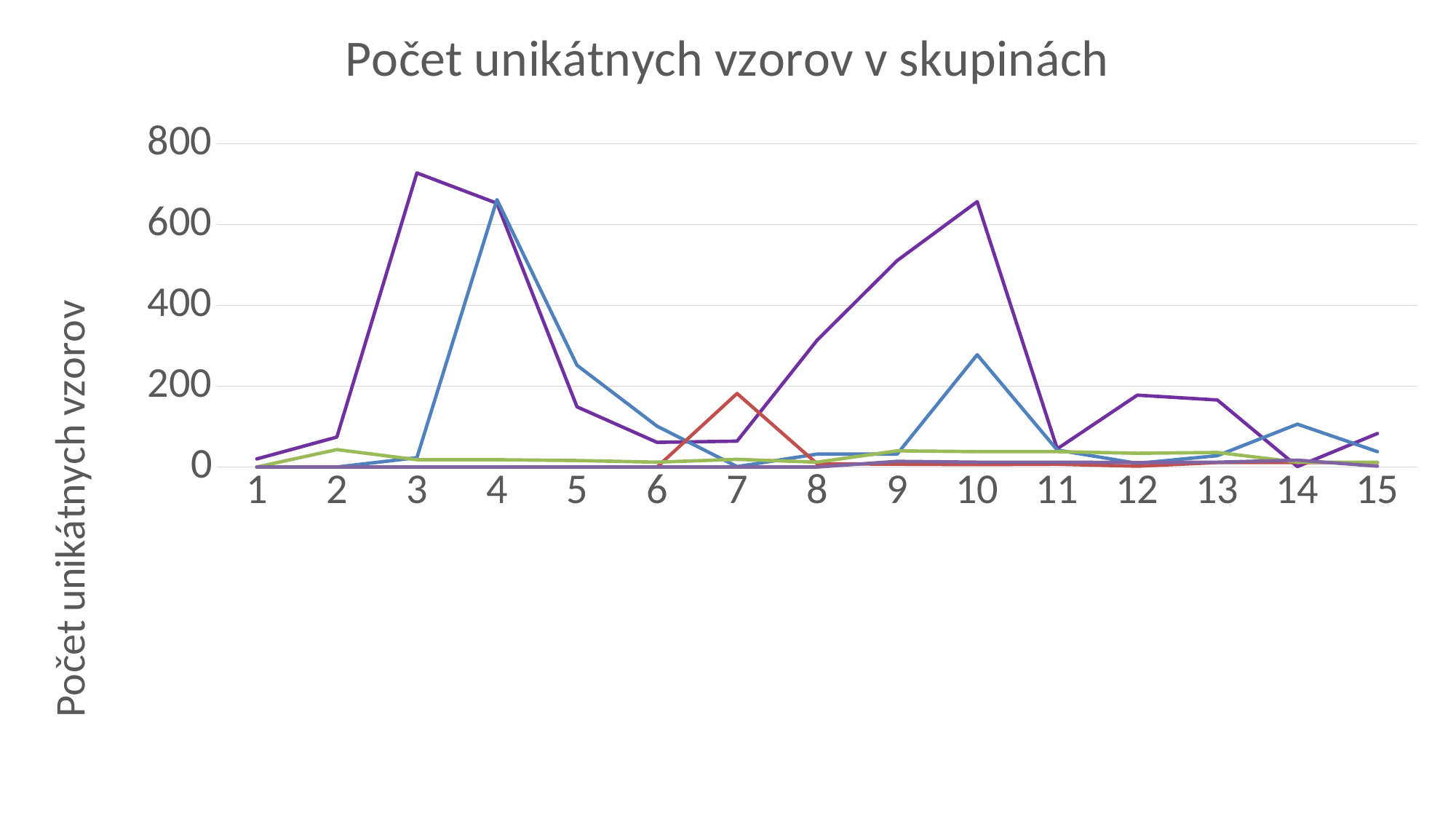
Is the value of the purple line at category 10 greater or less than 600? greater Is the value of the blue line at category 4 greater or less than 600? greater What is the label on the vertical axis of the chart? Počet unikátnych vzorov Is the value of the purple line at category 11 greater or less than 200? less Which is larger for the blue line: the value at category 4 or the value at category 10? category 4 How many categories are shown along the x axis of the chart? 15 What kind of chart is shown on the slide? line chart Does the purple line rise or fall between category 6 and category 10? rise What is the title of the chart? Počet unikátnych vzorov v skupinách At which category does the purple line reach its highest value? 3